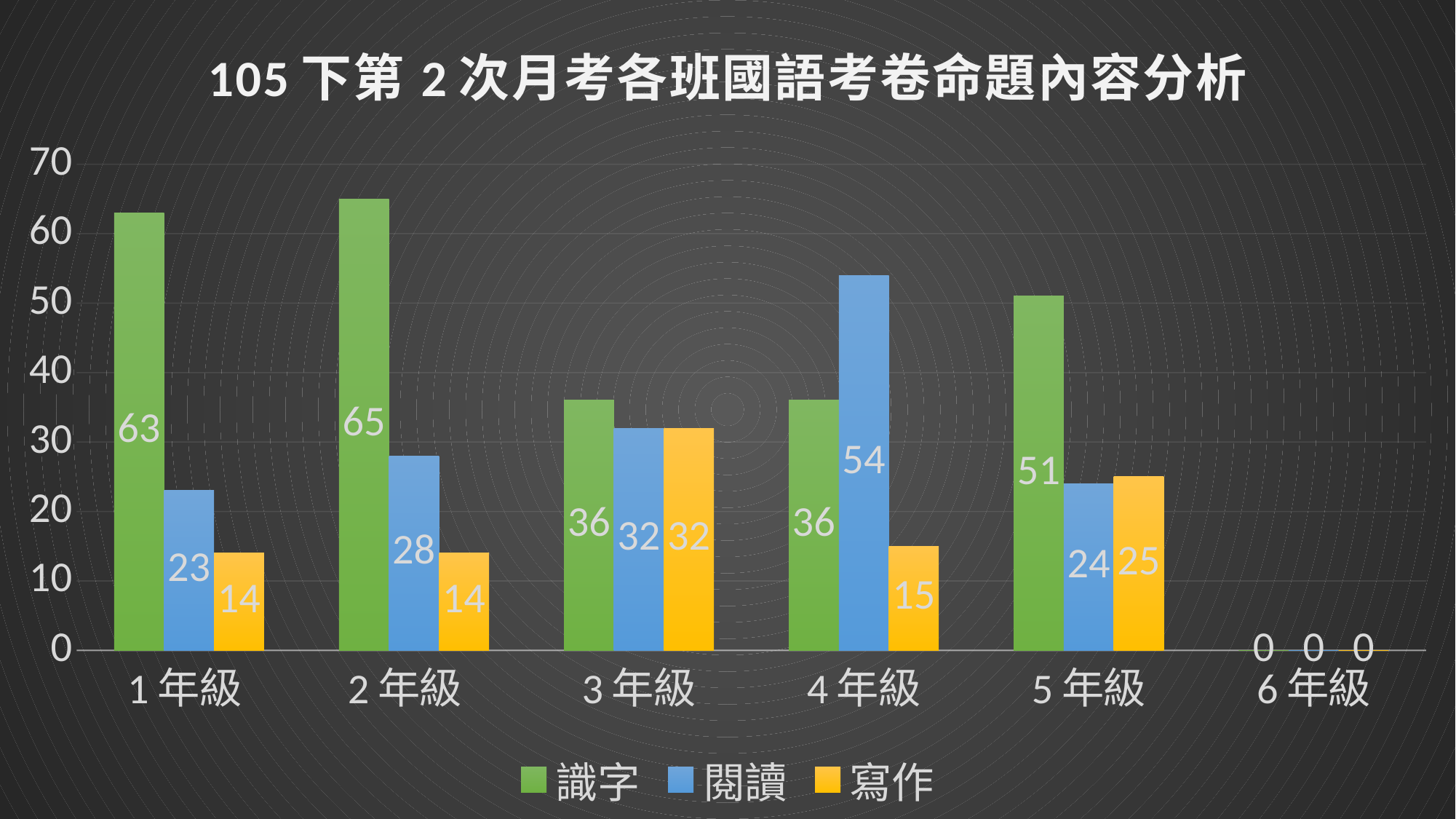
Which grade has the highest 識字 value? 2 年級 For 4 年級, which is larger, 識字 or 閱讀? 閱讀 What is the title of the chart? 105 下第 2 次月考各班國語考卷命題內容分析 What is the value of 閱讀 for 4 年級? 54 What is the value of 識字 for 1 年級? 63 What kind of chart is shown on the slide? Bar chart How many series does the legend list? 3 How many grade categories are shown on the x axis? 6 Which grade has the lowest 閱讀 value? 6 年級 What is the value of 寫作 for 5 年級? 25 What is the total of the three values for 3 年級? 100 What is the difference between the 識字 and 閱讀 values for 2 年級? 37